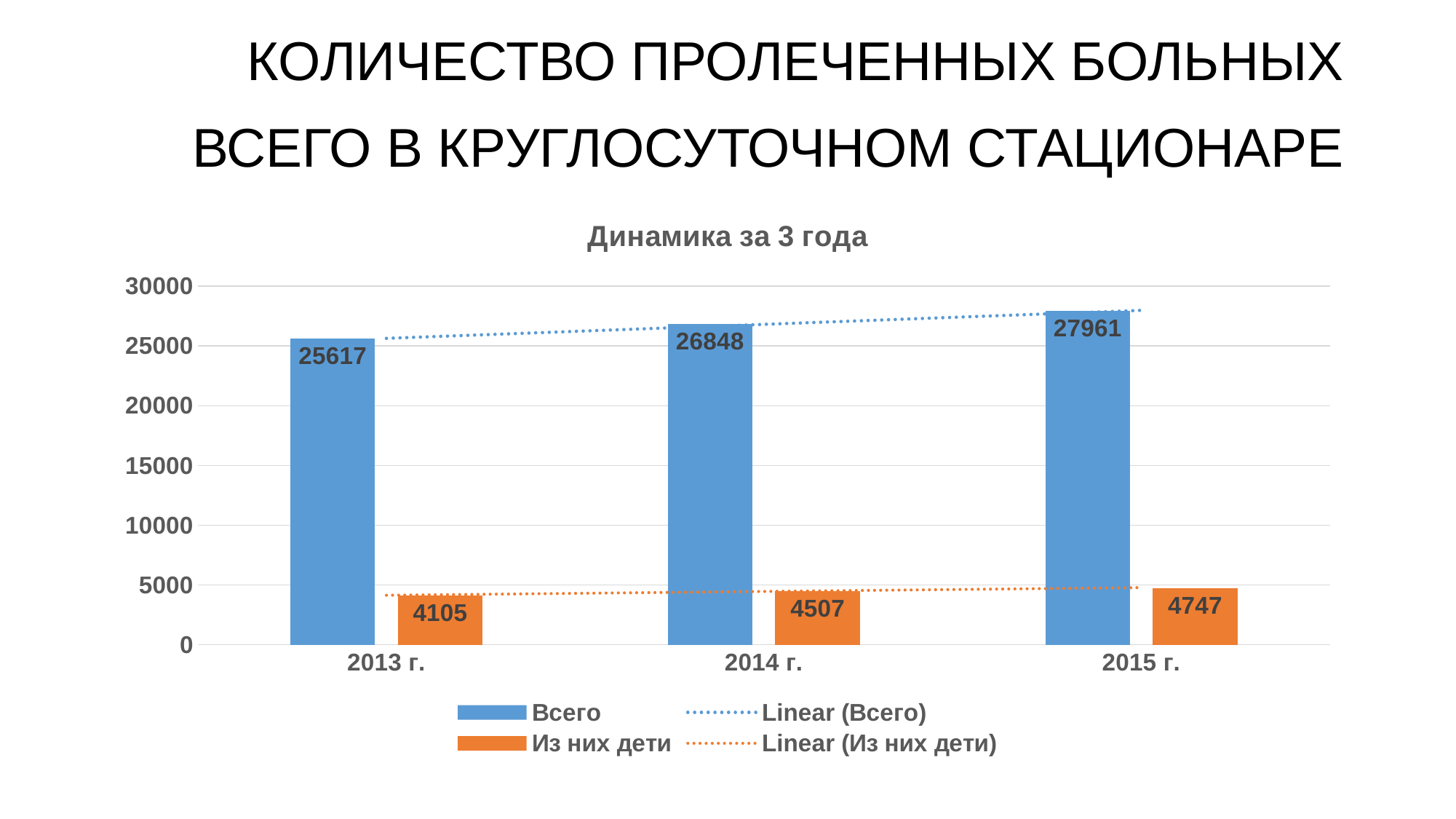
Is the value for Всего in 2013 г. greater or less than 25000? greater What is the difference between the Всего values for 2015 г. and 2013 г.? 2344 What is the value for Из них дети in 2015 г.? 4747 What is the value for Всего in 2014 г.? 26848 What is the difference between the Из них дети values for 2014 г. and 2013 г.? 402 What is the value for Всего in 2013 г.? 25617 What kind of chart is this? bar chart Do the Всего values rise or fall from 2013 г. to 2015 г.? rise Which is larger: Из них дети in 2014 г. or Из них дети in 2015 г.? 2015 г. How many years are shown on the x axis? 3 In which year is the Всего value highest? 2015 г. In which year is the Из них дети value lowest? 2013 г.